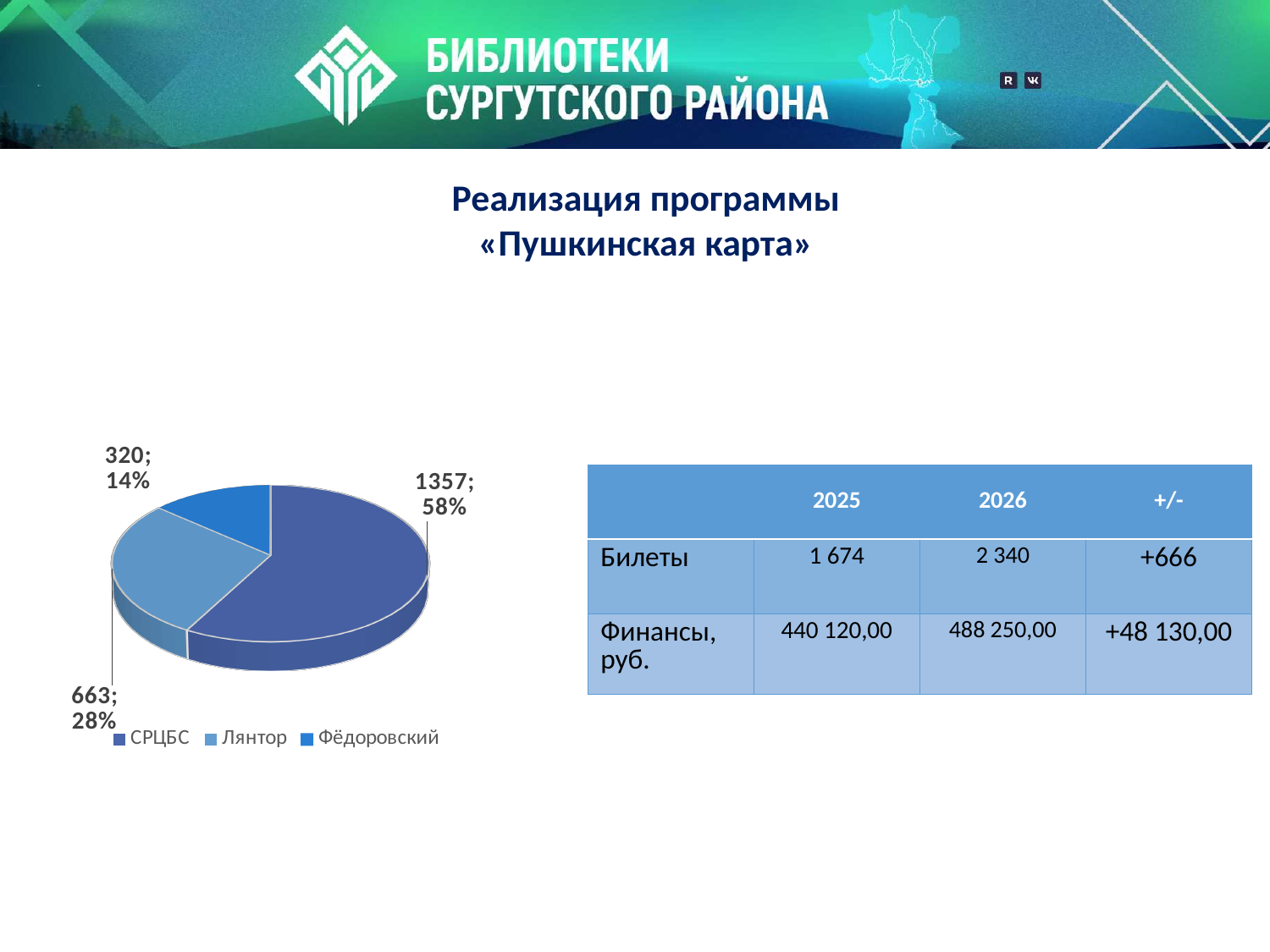
What kind of chart is shown on the slide? Pie chart What value is shown for СРЦБС in the pie chart? 1357 Which category has the smallest slice in the pie chart? Фёдоровский Which is larger in the pie chart, Лянтор or Фёдоровский? Лянтор How many slices does the pie chart have? 3 What value is shown for Лянтор in the pie chart? 663 How many entries does the legend of the pie chart list? 3 What share of the pie does Фёдоровский account for? 14% Which category has the largest slice in the pie chart? СРЦБС What is the difference between the values for СРЦБС and Лянтор in the pie chart? 694 What share of the pie does СРЦБС account for? 58% What value is shown for Фёдоровский in the pie chart? 320